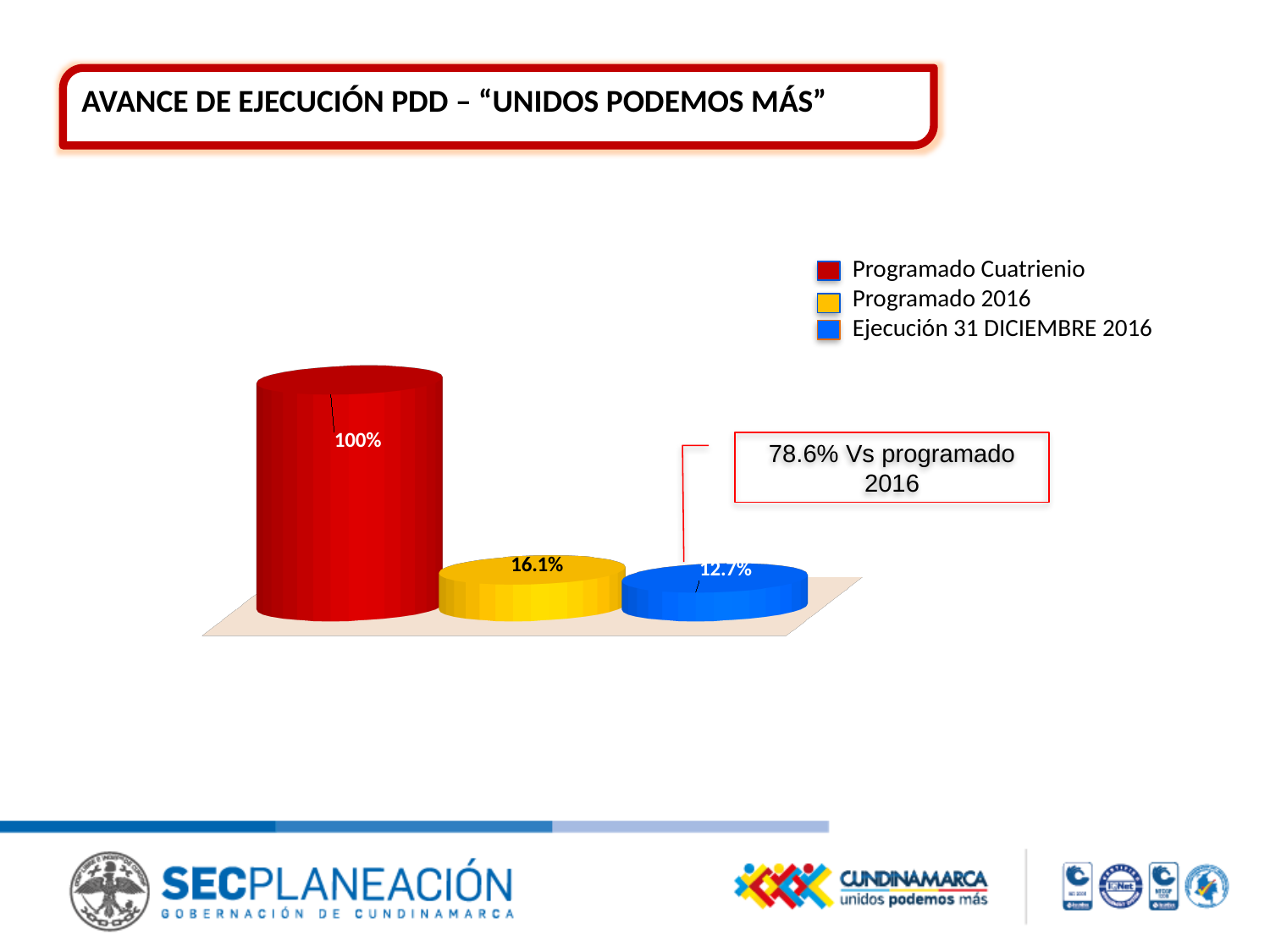
What percentage does the callout box give for execution versus programado 2016? 78.6% How many series does the legend list? 3 What is the difference between Programado Cuatrienio and Programado 2016? 83.9% Which series has the lowest value? Ejecución 31 DICIEMBRE 2016 What value is shown for Programado Cuatrienio? 100% What value is shown for Programado 2016? 16.1% What kind of chart is shown on the slide? Bar chart Which is larger, Programado 2016 or Ejecución 31 DICIEMBRE 2016? Programado 2016 Which series has the highest value? Programado Cuatrienio What is the difference between Programado 2016 and Ejecución 31 DICIEMBRE 2016? 3.4% What colour represents Ejecución 31 DICIEMBRE 2016 in the legend? Blue What value is shown for Ejecución 31 DICIEMBRE 2016? 12.7%